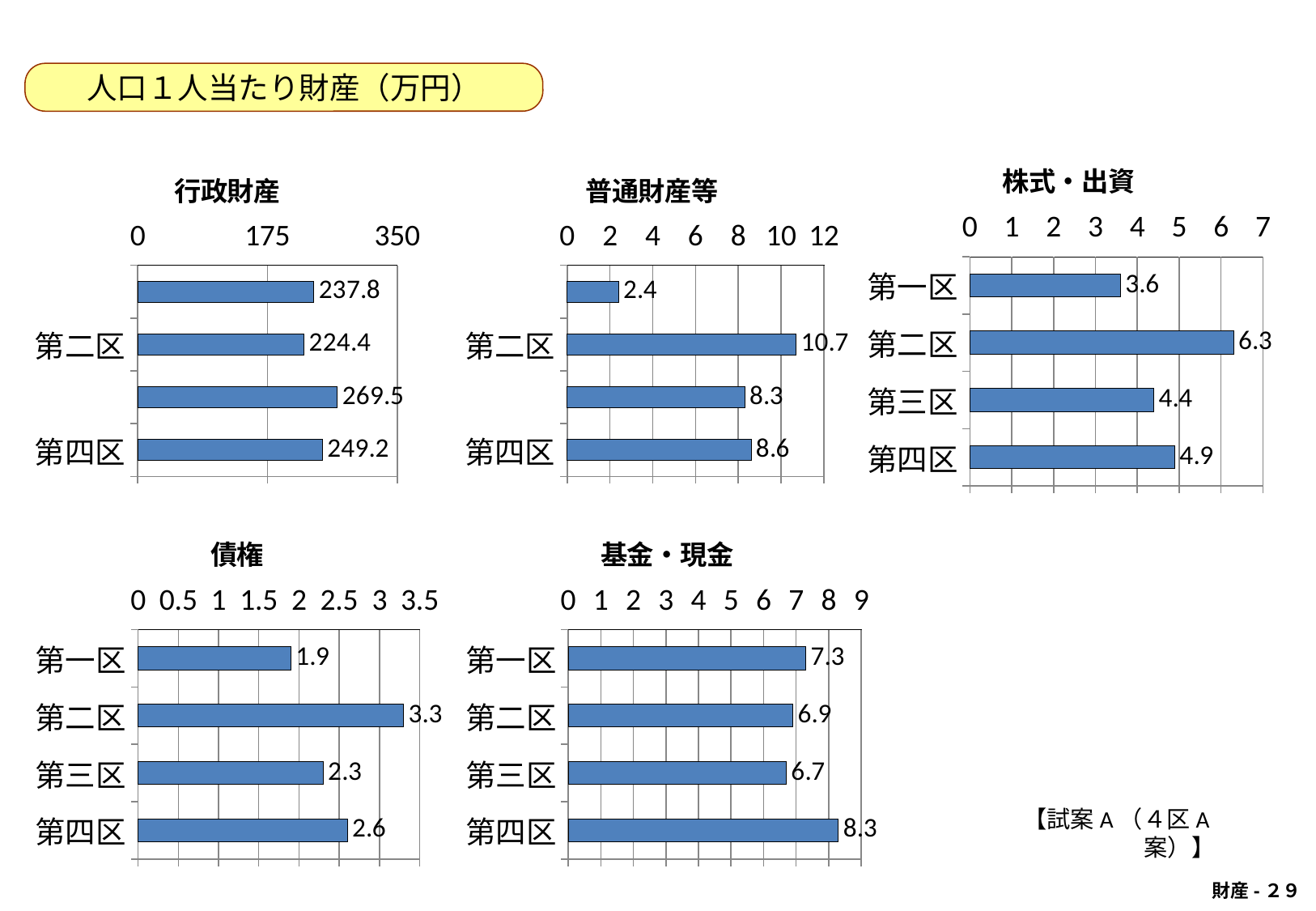
In the 株式・出資 chart, which district has the highest value? 第二区 In the 債権 chart, what is the value for 第三区? 2.3 In the 普通財産等 chart, what is the difference between 第二区 and 第四区? 2.1 In the 行政財産 chart, what is the value for 第四区? 249.2 In the 債権 chart, which is larger, 第一区 or 第四区? 第四区 In the 株式・出資 chart, which district has the lowest value? 第一区 In the 基金・現金 chart, which district has the highest value? 第四区 In the 基金・現金 chart, what is the difference between 第四区 and 第三区? 1.6 How many bars does the 債権 chart show? 4 What type of chart is the 株式・出資 chart? Bar chart In the 普通財産等 chart, what is the value for 第二区? 10.7 In the 行政財産 chart, what is the value for 第二区? 224.4